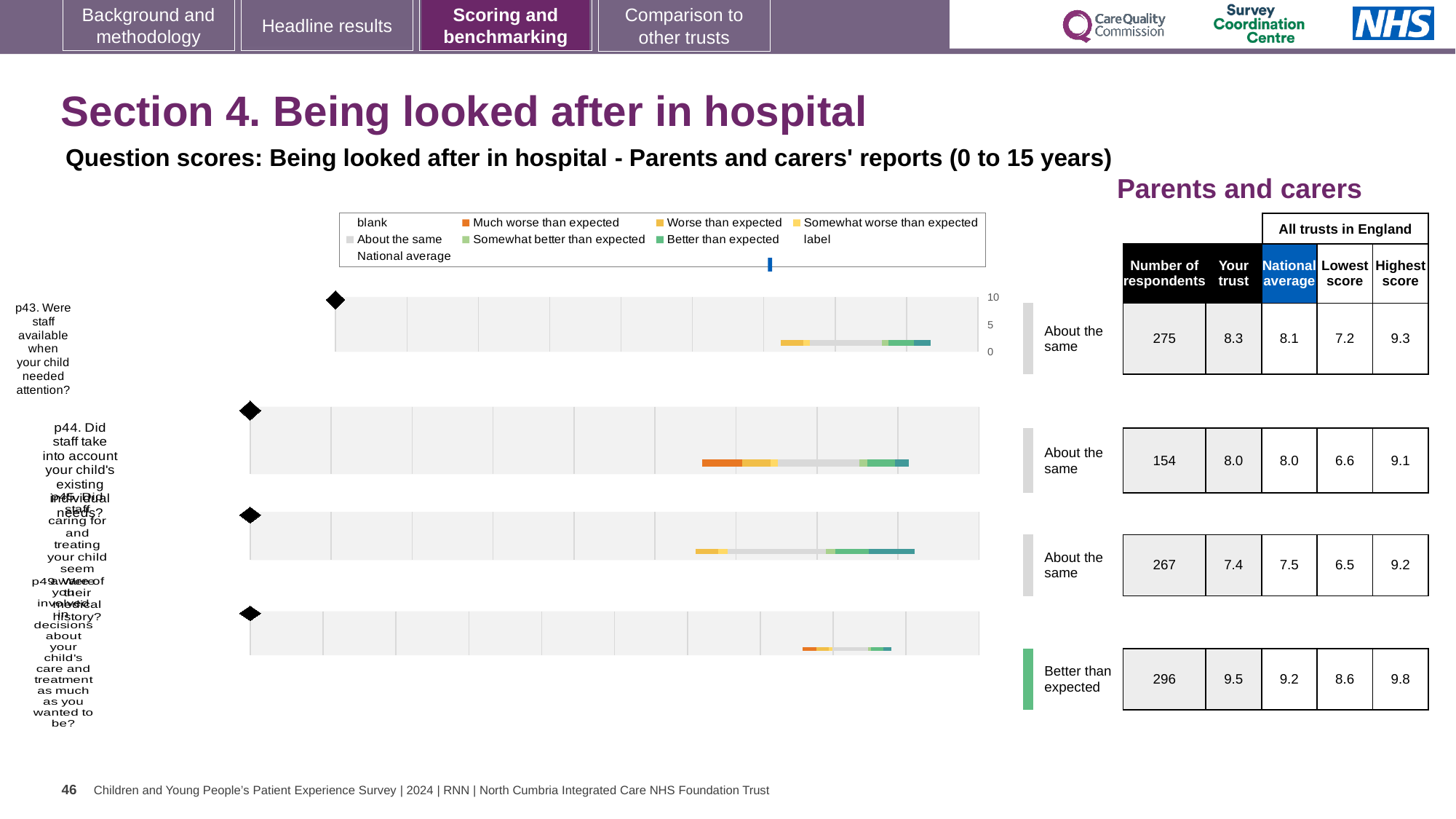
What benchmark category is shown for p49? Better than expected What is the 'Your trust' score for p43 (Were staff available when your child needed attention?)? 8.3 For p43, what is the difference between the 'Your trust' score and the national average? 0.2 For p49, which is larger: the 'Your trust' score or the national average? Your trust How many questions are plotted on the chart? 4 What kind of chart is used to show the question scores? Bar chart What is the lowest score among all trusts in England for p44? 6.6 Which question has the highest 'Your trust' score? p49 What is the national average score for p45? 7.5 How many respondents are shown for p44 (Did staff take into account your child's existing individual needs?)? 154 Which question has the lowest 'Your trust' score? p45 What is the highest score among all trusts in England for p49? 9.8